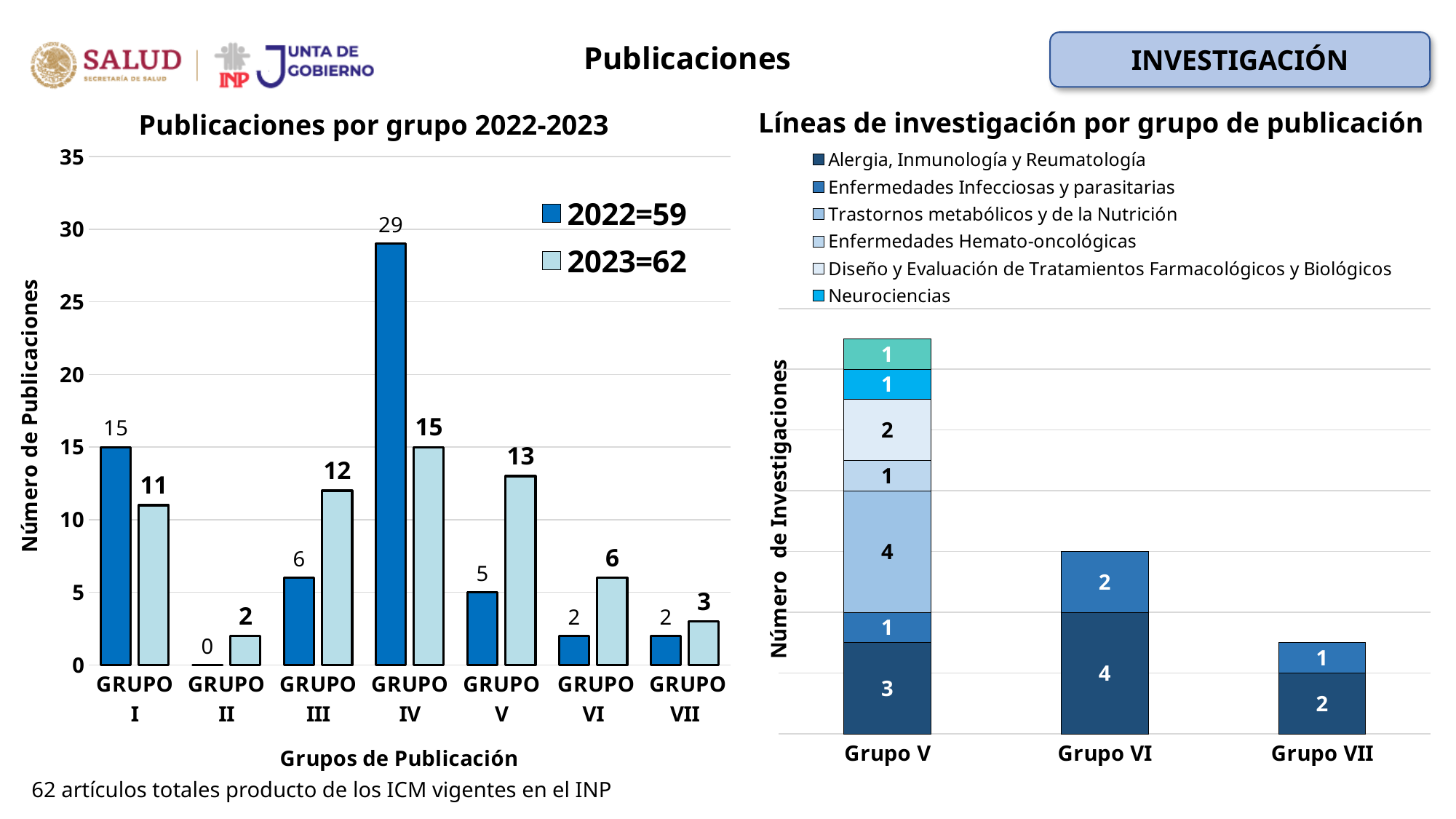
How many series does the legend of the chart 'Publicaciones por grupo 2022-2023' list? 2 What kind of chart is 'Líneas de investigación por grupo de publicación'? Stacked bar chart How many entries does the legend of the chart 'Líneas de investigación por grupo de publicación' list? 6 In the chart 'Líneas de investigación por grupo de publicación', what is the value of the 'Alergia, Inmunología y Reumatología' segment for Grupo VII? 2 In the chart 'Líneas de investigación por grupo de publicación', what is the total of the stacked bar for Grupo VI? 6 In the chart 'Publicaciones por grupo 2022-2023', which is larger for GRUPO III: the 2022 value or the 2023 value? 2023 In the chart 'Publicaciones por grupo 2022-2023', which group has the highest value for 2022? GRUPO IV In the chart 'Publicaciones por grupo 2022-2023', what is the value for GRUPO IV in 2022? 29 In the chart 'Publicaciones por grupo 2022-2023', what is the value for GRUPO V in 2023? 13 In the chart 'Publicaciones por grupo 2022-2023', which group has the lowest value for 2023? GRUPO II In the chart 'Publicaciones por grupo 2022-2023', what is the difference between the 2022 and 2023 values for GRUPO IV? 14 How many groups are shown on the x axis of the chart 'Publicaciones por grupo 2022-2023'? 7